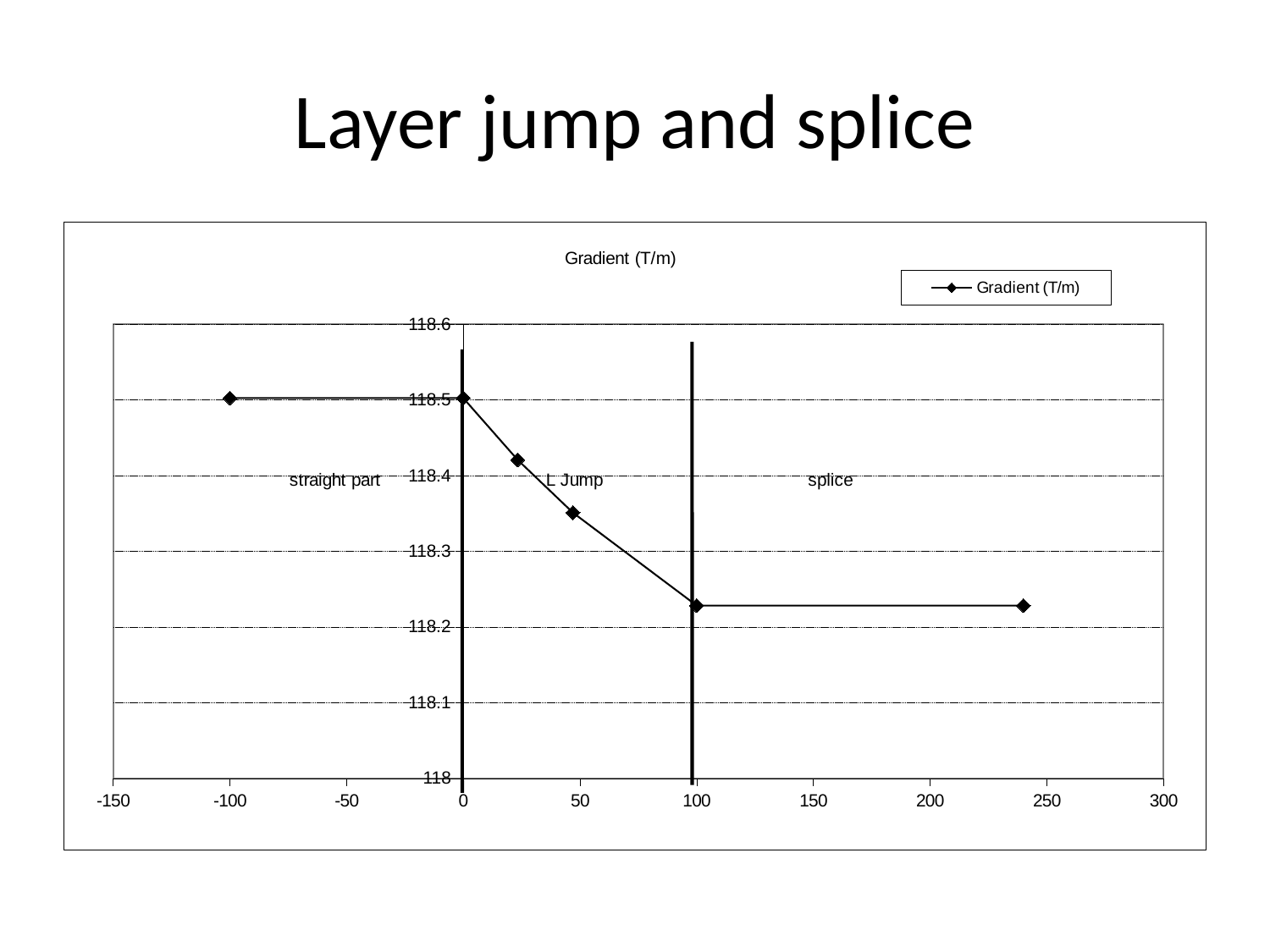
What kind of chart is shown on the slide? line chart Is the Gradient value at x = -100 greater or less than 118.4? greater How many series does the legend list? 1 What is the Gradient (T/m) value at x = 0? 118.5 Is the Gradient value at x = 240 greater or less than 118.3? less Do the Gradient values rise or fall as x increases from 0 to 100? fall How many data points are plotted on the line? 6 What is the title of the chart? Gradient (T/m) What is the Gradient (T/m) value at x = -100? 118.5 What are the three region labels written inside the plot area, from left to right? straight part, L Jump, splice Which has the larger Gradient value, the point at x = -100 or the point at x = 240? x = -100 Is the Gradient value at x = 100 greater or less than 118.3? less